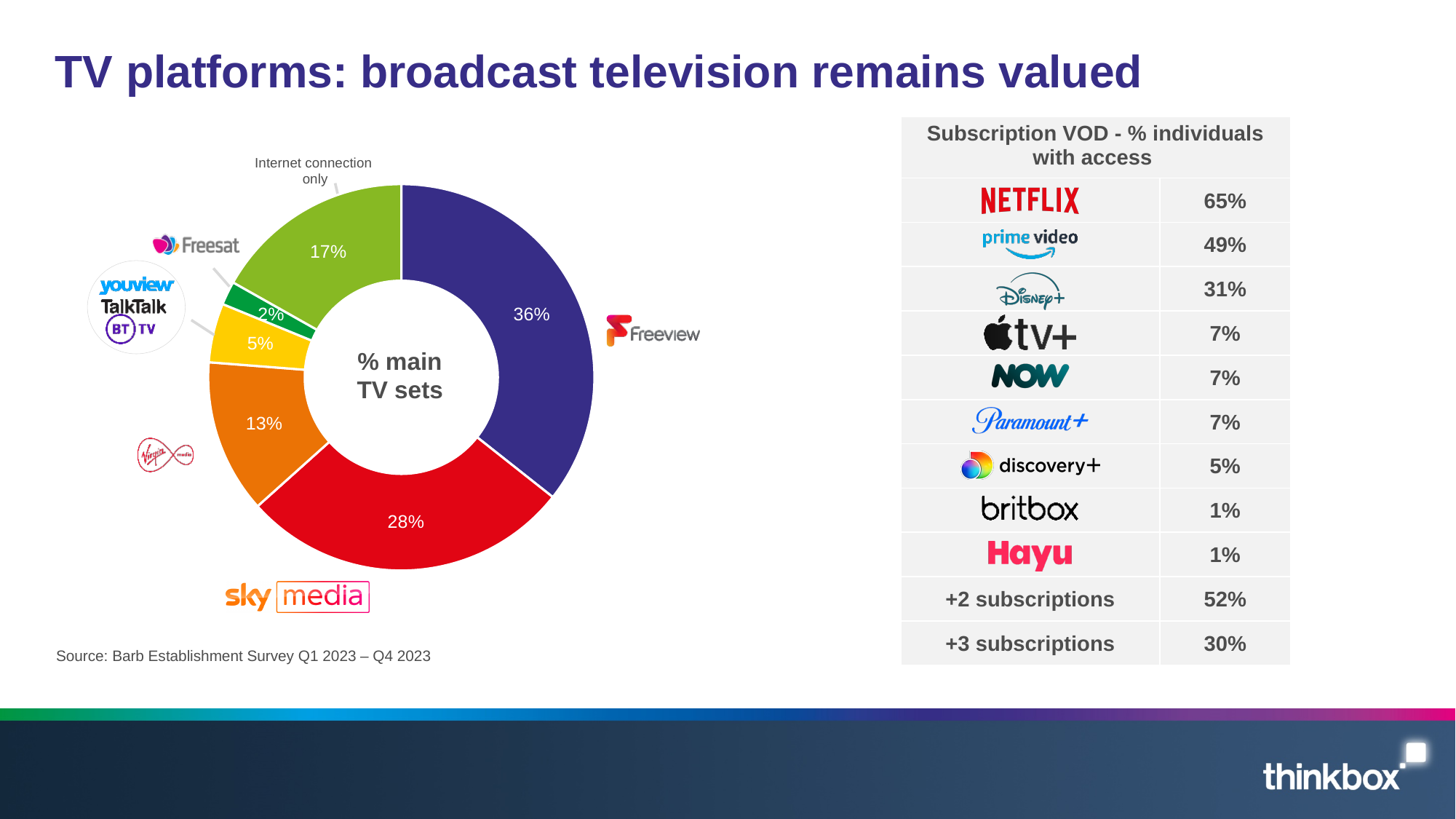
In the % main TV sets chart, what percentage is shown for the YouView / TalkTalk / BT TV slice? 5% In the % main TV sets chart, how many percentage points larger is Freeview's slice than Sky's? 8 percentage points In the % main TV sets chart, what percentage is shown for Virgin Media? 13% Which platform has the smallest slice in the % main TV sets chart? Freesat In the % main TV sets chart, what percentage is shown for Sky? 28% Which platform has the largest slice in the % main TV sets chart? Freeview In the % main TV sets chart, what percentage is shown for Internet connection only? 17% In the % main TV sets chart, what share of main TV sets is Freeview? 36% In the % main TV sets chart, which is larger: the Virgin Media slice or the Internet connection only slice? Internet connection only What kind of chart is shown on the left of the slide? pie chart (donut) How many slices does the % main TV sets chart have? 6 In the % main TV sets chart, what percentage is shown for Freesat? 2%